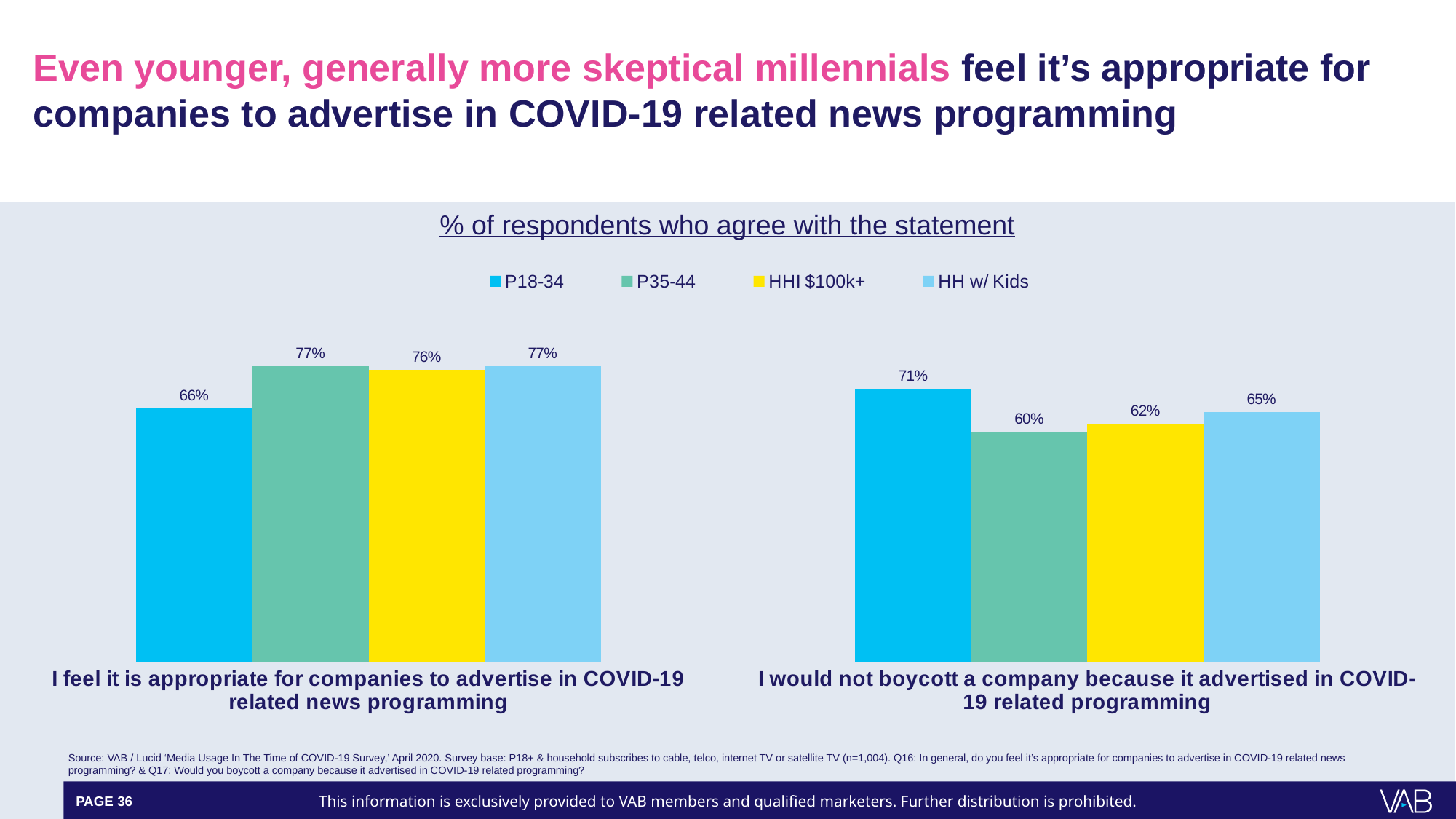
For the statement 'I would not boycott a company because it advertised in COVID-19 related programming', is the value for HHI $100k+ or HH w/ Kids larger? HH w/ Kids What percentage of P18-34 respondents agree that it is appropriate for companies to advertise in COVID-19 related news programming? 66% Which group has the lowest share agreeing with 'I would not boycott a company because it advertised in COVID-19 related programming'? P35-44 What is the difference between the P18-34 value and the P35-44 value for 'I would not boycott a company because it advertised in COVID-19 related programming'? 11 percentage points How many series does the legend list? 4 Which group has the highest share agreeing with 'I would not boycott a company because it advertised in COVID-19 related programming'? P18-34 What is the value for HHI $100k+ on the statement 'I feel it is appropriate for companies to advertise in COVID-19 related news programming'? 76% What percentage of HH w/ Kids respondents agree they would not boycott a company because it advertised in COVID-19 related programming? 65% Which group has the lowest share agreeing with 'I feel it is appropriate for companies to advertise in COVID-19 related news programming'? P18-34 How many statements (categories) are shown on the x axis? 2 What kind of chart is shown on the slide? Bar chart What is the difference in percentage points between P35-44 and P18-34 on the statement about it being appropriate for companies to advertise in COVID-19 related news programming? 11 percentage points